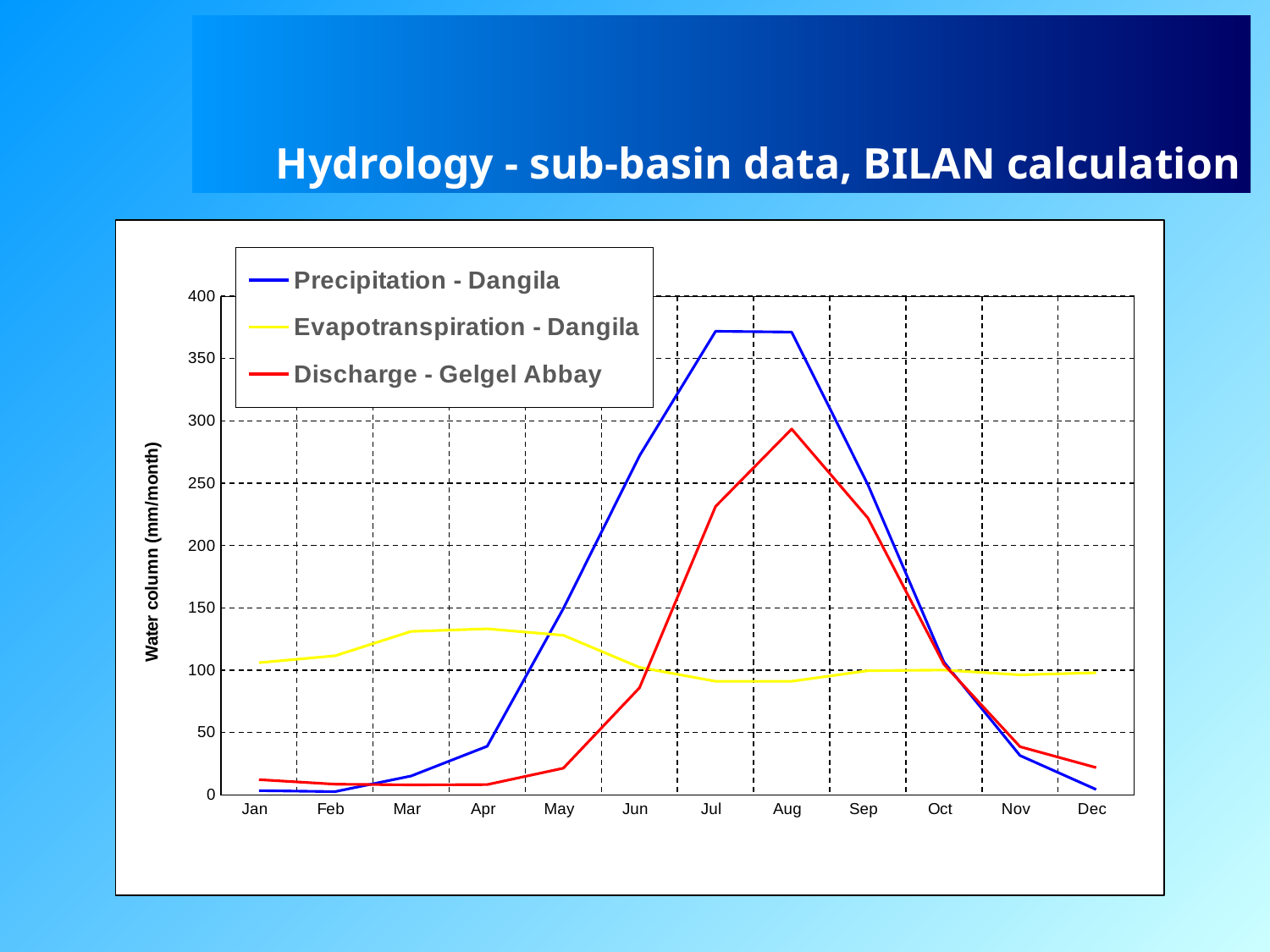
Is the value for Precipitation - Dangila in Jan greater or less than 50? less In Jan, which is larger: Evapotranspiration - Dangila or Precipitation - Dangila? Evapotranspiration - Dangila What is the label of the y axis? Water column (mm/month) How many months are shown along the x axis? 12 Is the value for Precipitation - Dangila in Jul greater or less than 350? greater What kind of chart is shown on the slide? line chart Does Precipitation - Dangila rise or fall from Aug to Dec? fall In which month is Discharge - Gelgel Abbay highest? Aug How many series does the legend list? 3 Is the value for Evapotranspiration - Dangila in Apr greater or less than 100? greater In Jul, which is larger: Precipitation - Dangila or Discharge - Gelgel Abbay? Precipitation - Dangila